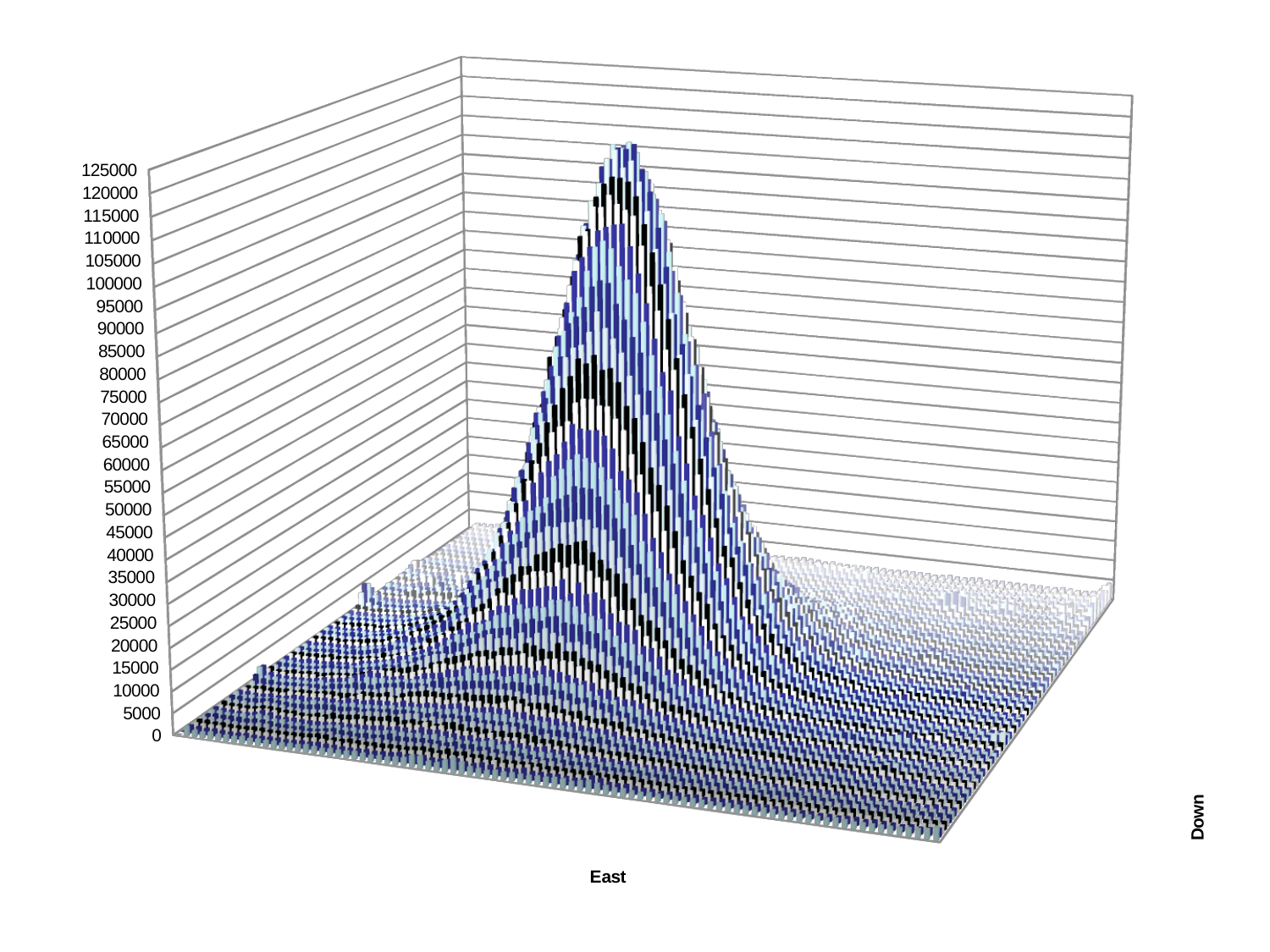
Is the value of the tallest bar in the chart greater or less than 75000? greater What is the highest value labelled on the vertical axis of the chart? 125000 Is the value of the tallest bar in the chart greater or less than 50000? greater What are the labels on the two horizontal axes of the chart? East and Down What kind of chart is shown on the slide? bar chart